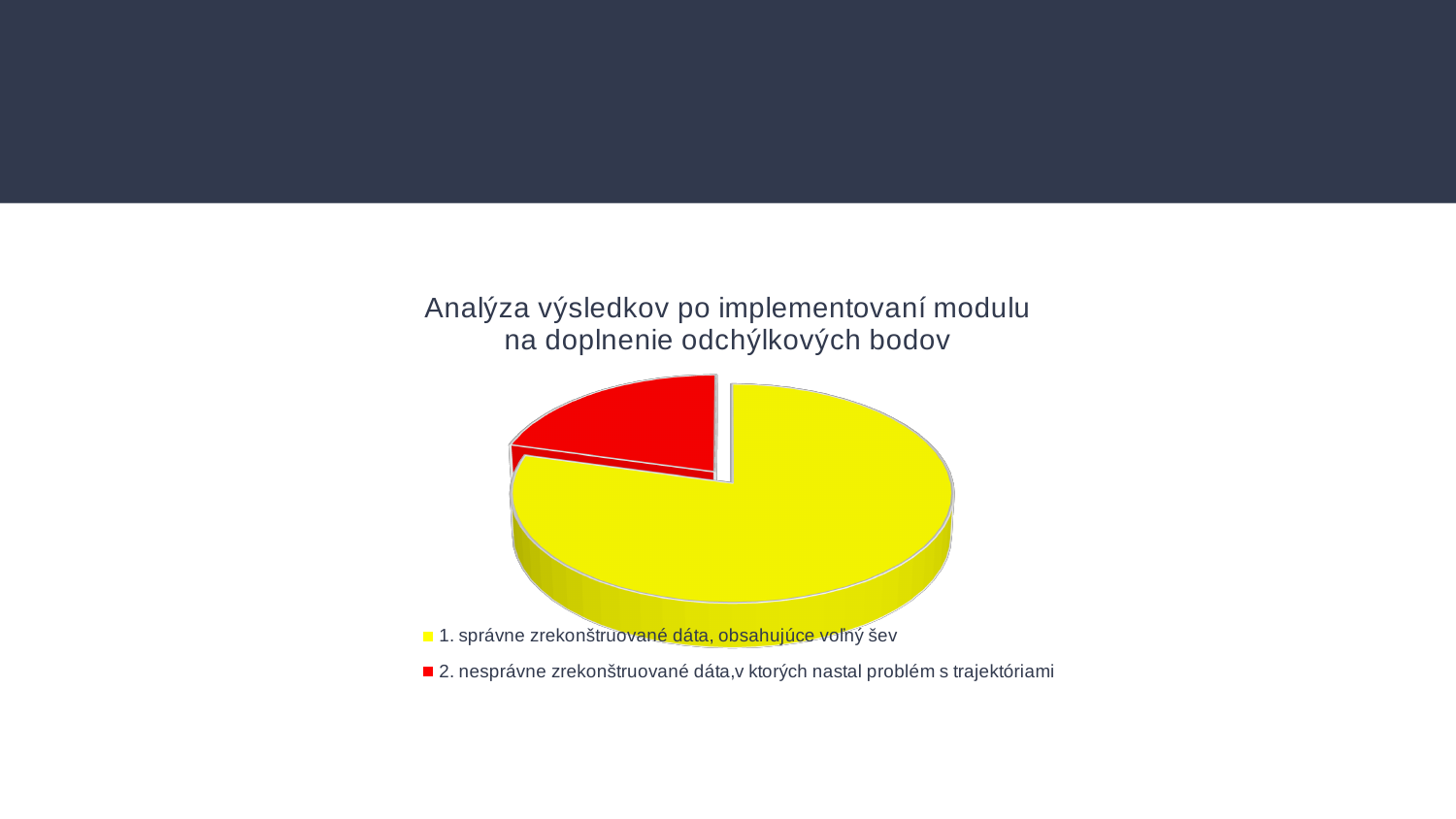
Does the slice for '1. správne zrekonštruované dáta, obsahujúce voľný šev' cover more or less than half of the pie? more What kind of chart is shown on the slide? Pie chart What is the title of the pie chart? Analýza výsledkov po implementovaní modulu na doplnenie odchýlkových bodov What colour is the slice for '2. nesprávne zrekonštruované dáta,v ktorých nastal problém s trajektóriami'? Red Which slice is larger: the one for correctly reconstructed data (1.) or the one for incorrectly reconstructed data (2.)? 1. správne zrekonštruované dáta, obsahujúce voľný šev Which category has the largest slice in the pie chart? 1. správne zrekonštruované dáta, obsahujúce voľný šev Which category has the smallest slice in the pie chart? 2. nesprávne zrekonštruované dáta,v ktorých nastal problém s trajektóriami How many entries does the legend of the pie chart list? 2 Does the slice for '2. nesprávne zrekonštruované dáta' cover more or less than half of the pie? less How many slices does the pie chart have? 2